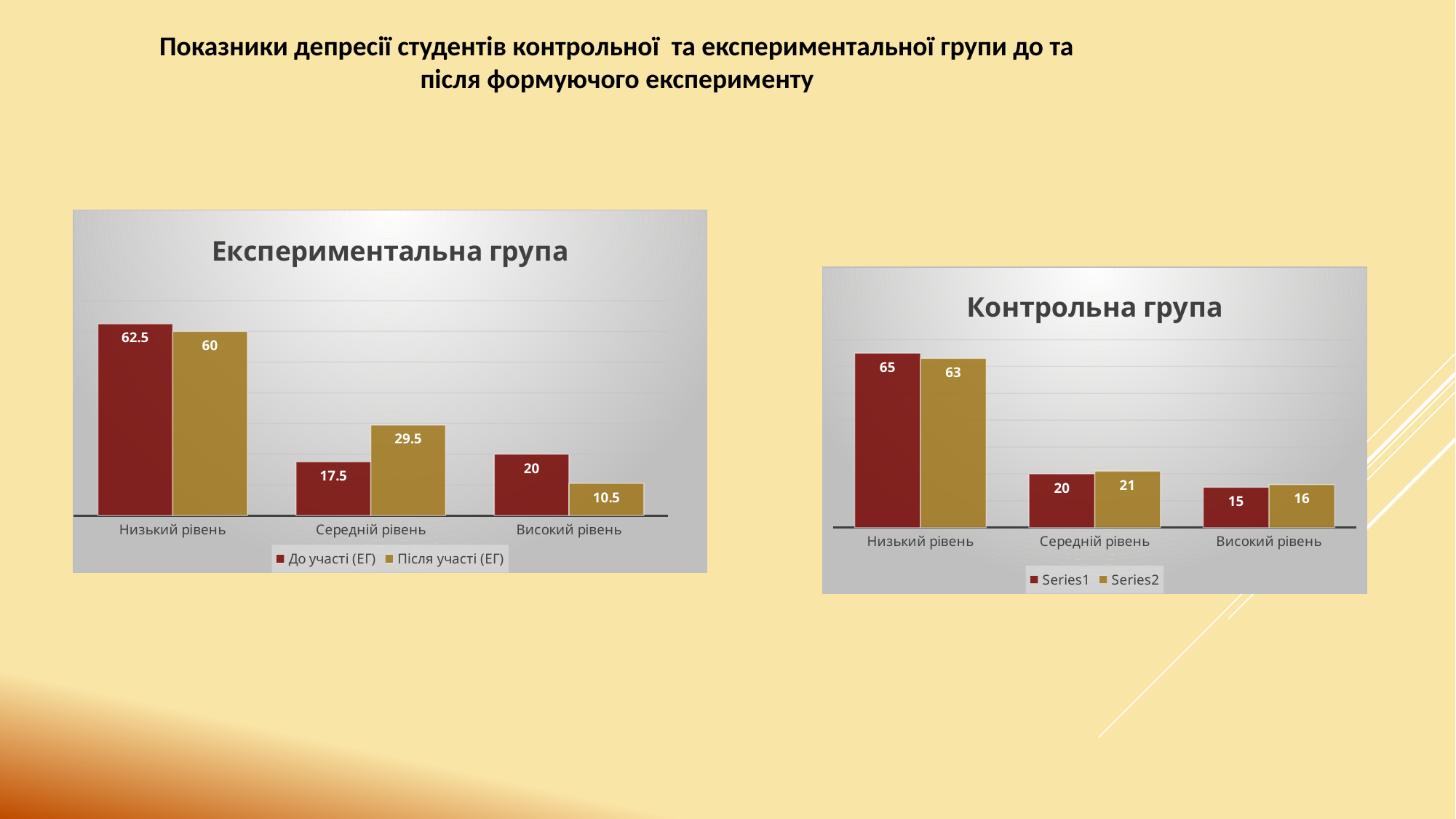
In the "Контрольна група" chart, what is the difference between Series1 and Series2 at "Низький рівень"? 2 In the "Контрольна група" chart, what is the value for Series2 at "Високий рівень"? 16 In the "Експериментальна група" chart, what is the difference between "Після участі (ЕГ)" and "До участі (ЕГ)" at "Середній рівень"? 12 How many series does the legend of the "Експериментальна група" chart list? 2 In the "Експериментальна група" chart, what is the value for "Після участі (ЕГ)" at "Високий рівень"? 10.5 In the "Експериментальна група" chart, which category has the lowest value for "Після участі (ЕГ)"? Високий рівень In the "Контрольна група" chart, which category has the highest value for Series1? Низький рівень In the "Контрольна група" chart, what is the value for Series1 at "Низький рівень"? 65 In the "Експериментальна група" chart, what is the value for "До участі (ЕГ)" at "Низький рівень"? 62.5 In the "Експериментальна група" chart, what is the value for "Після участі (ЕГ)" at "Середній рівень"? 29.5 In the "Експериментальна група" chart, which is larger at "Високий рівень": "До участі (ЕГ)" or "Після участі (ЕГ)"? До участі (ЕГ) How many categories are shown on the x axis of the "Контрольна група" chart? 3